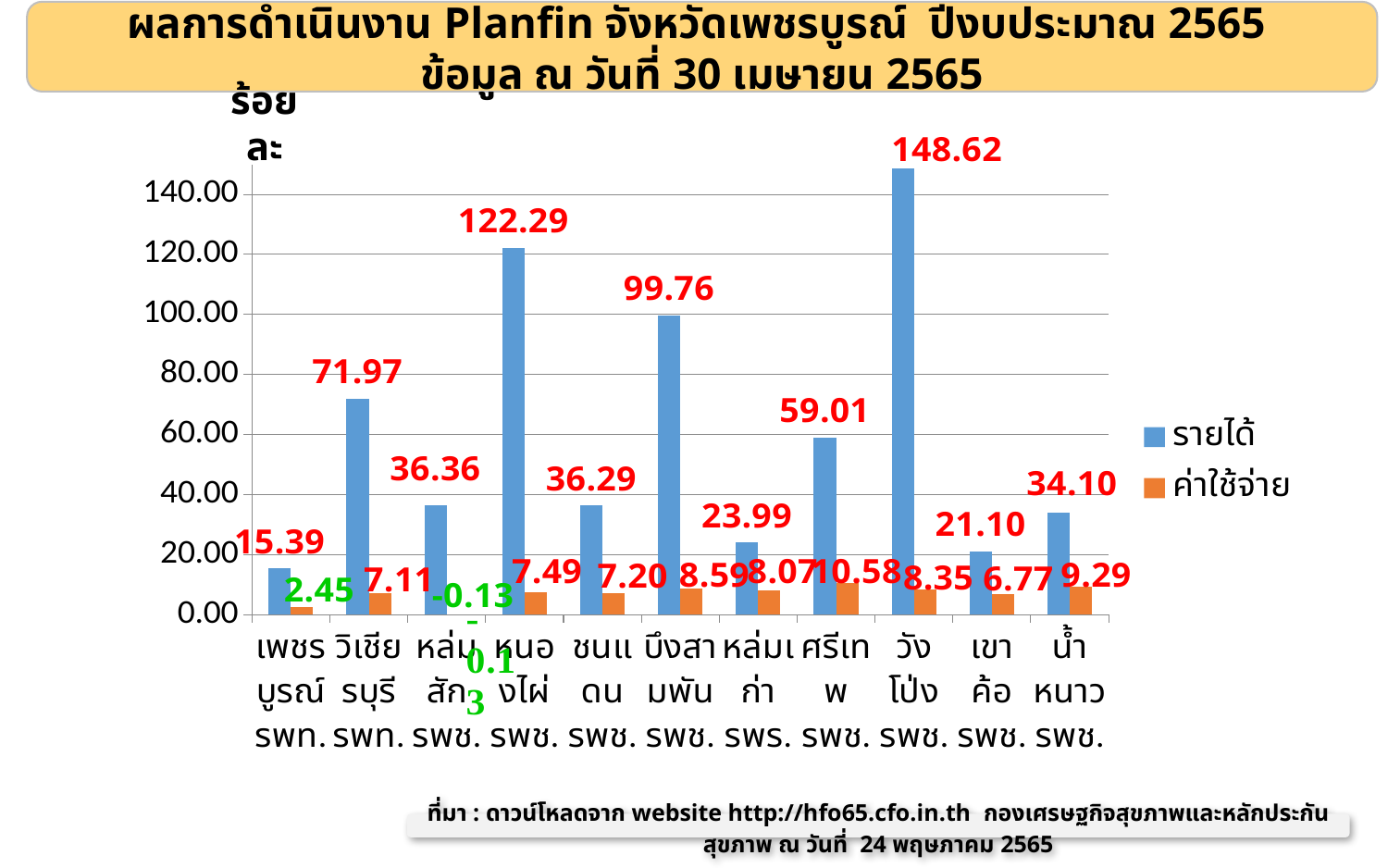
Which is larger, the รายได้ value for วิเชียรบุรี รพท. or for ศรีเทพ รพช.? วิเชียรบุรี รพท. How many hospitals (categories) are shown on the x axis? 11 Which series is shown in orange in the legend? ค่าใช้จ่าย Is the รายได้ value for บึงสามพัน รพช. greater or less than 100.00? less What is the รายได้ value for หนองไผ่ รพช.? 122.29 What is the ค่าใช้จ่าย value for ศรีเทพ รพช.? 10.58 Which hospital has the highest รายได้ value? วังโป่ง รพช. Which hospital has the lowest รายได้ value? เพชรบูรณ์ รพท. How many series does the legend list? 2 What is the difference between the รายได้ values of วังโป่ง รพช. and หนองไผ่ รพช.? 26.33 What is the รายได้ value for วังโป่ง รพช.? 148.62 What type of chart is shown on the slide? bar chart